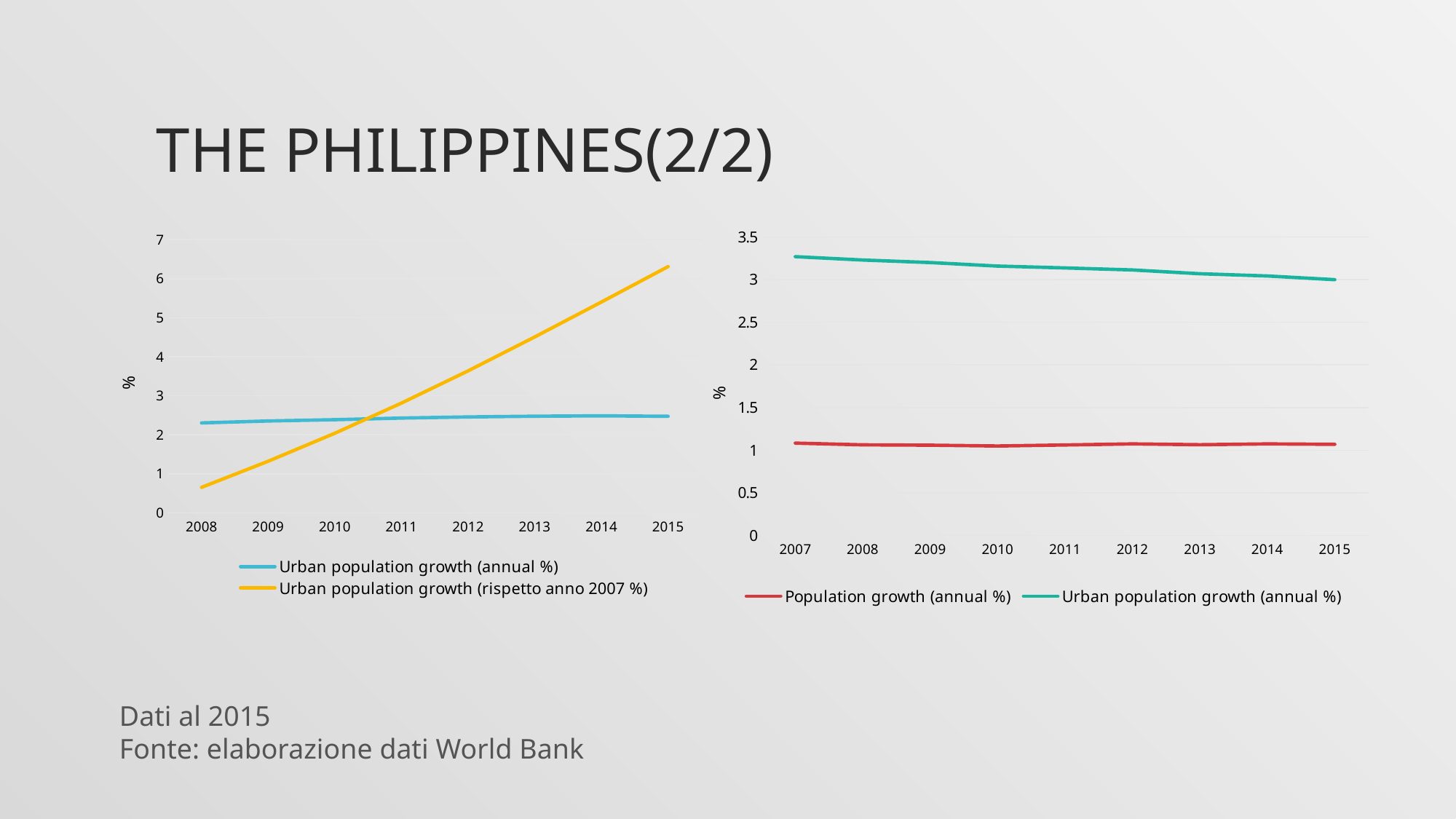
In the left chart, is the 2008 value for 'Urban population growth (rispetto anno 2007 %)' greater or less than 1? less In the left chart, is the 2015 value for 'Urban population growth (rispetto anno 2007 %)' greater or less than 5? greater How many years are shown on the x axis of the left chart? 8 In the left chart, does the 'Urban population growth (rispetto anno 2007 %)' series rise or fall from 2008 to 2015? rise How many years are shown on the x axis of the right chart? 9 In the right chart, which series has the larger value in 2015, 'Population growth (annual %)' or 'Urban population growth (annual %)'? Urban population growth (annual %) What kind of chart is the left chart on the slide? line chart How many series does the legend of the left chart list? 2 In the right chart, does the 'Urban population growth (annual %)' series rise or fall from 2007 to 2015? fall How many series does the legend of the right chart list? 2 What kind of chart is the right chart on the slide? line chart In the right chart, what colour is the line for 'Population growth (annual %)'? red